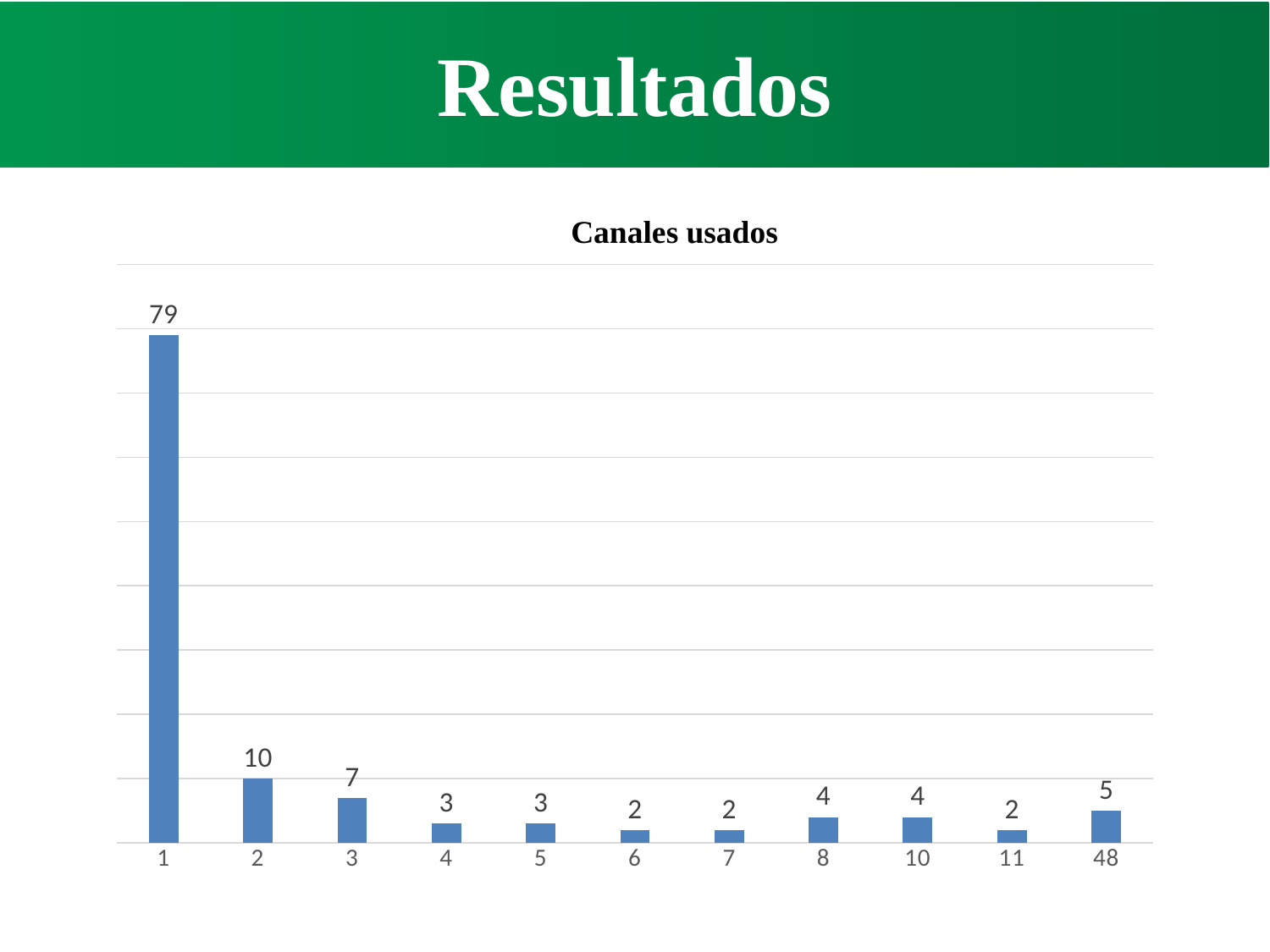
Which is larger, the value for category 3 or the value for category 48? category 3 What is the value for category 2? 10 What kind of chart is shown on the slide? bar chart What is the value for category 8? 4 Which is larger, the value for category 10 or the value for category 11? category 10 How many categories are shown on the x axis of the chart? 11 What is the difference between the values for category 1 and category 2? 69 What is the title of the chart? Canales usados What is the value for category 1? 79 Which category has the highest value? 1 What is the difference between the values for category 2 and category 3? 3 What is the value for category 48? 5